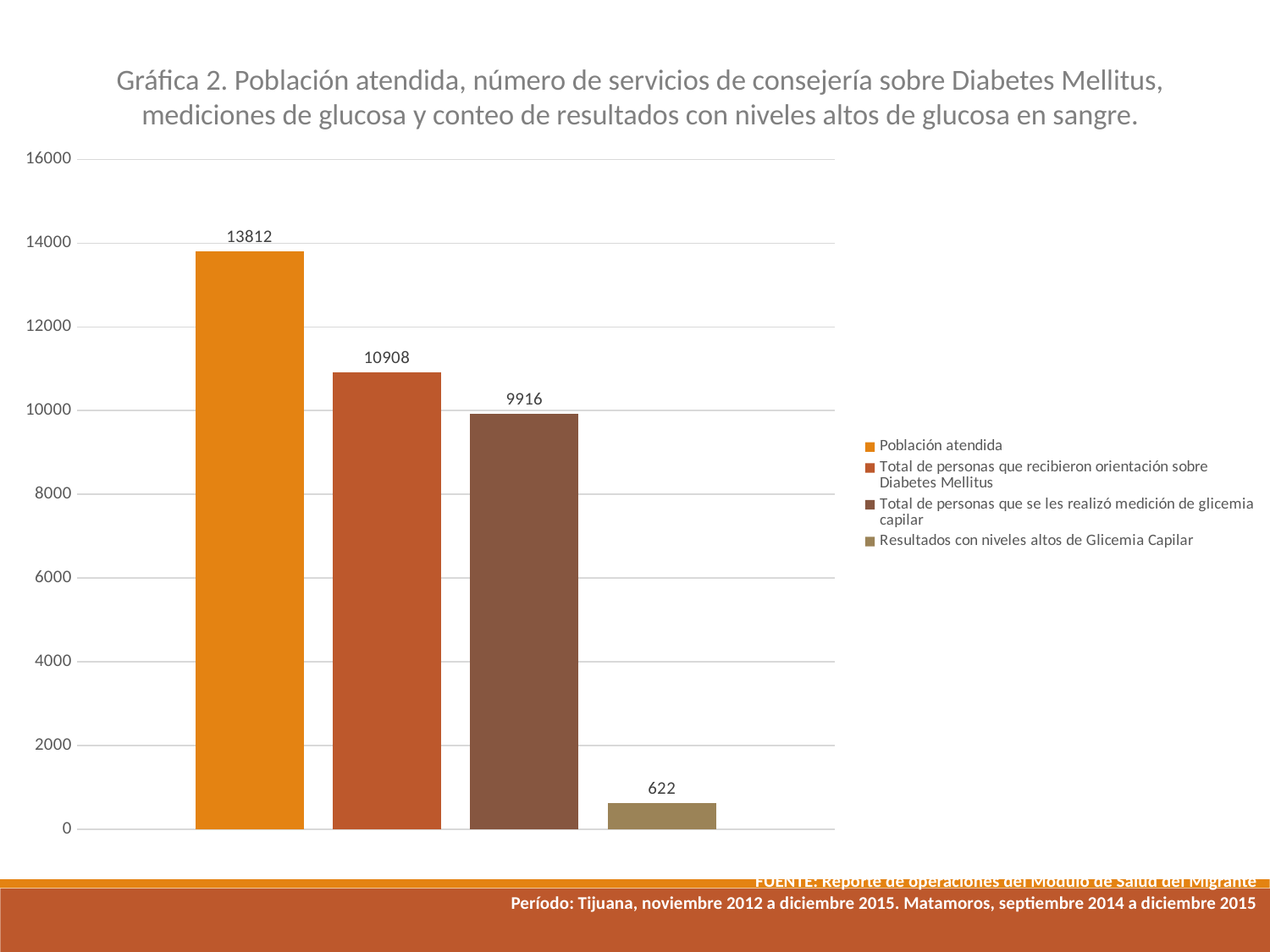
Which is larger: Total de personas que recibieron orientación sobre Diabetes Mellitus or Total de personas que se les realizó medición de glicemia capilar? Total de personas que recibieron orientación sobre Diabetes Mellitus Which series has the highest value? Población atendida Which series has the lowest value? Resultados con niveles altos de Glicemia Capilar What is the value for Población atendida? 13812 What is the value for Total de personas que se les realizó medición de glicemia capilar? 9916 What is the value for Resultados con niveles altos de Glicemia Capilar? 622 How many series does the legend list? 4 What is the difference between Población atendida and Total de personas que recibieron orientación sobre Diabetes Mellitus? 2904 What is the value for Total de personas que recibieron orientación sobre Diabetes Mellitus? 10908 What kind of chart is shown on the slide? Bar chart What is the maximum value shown on the vertical axis? 16000 What is the difference between Total de personas que se les realizó medición de glicemia capilar and Resultados con niveles altos de Glicemia Capilar? 9294